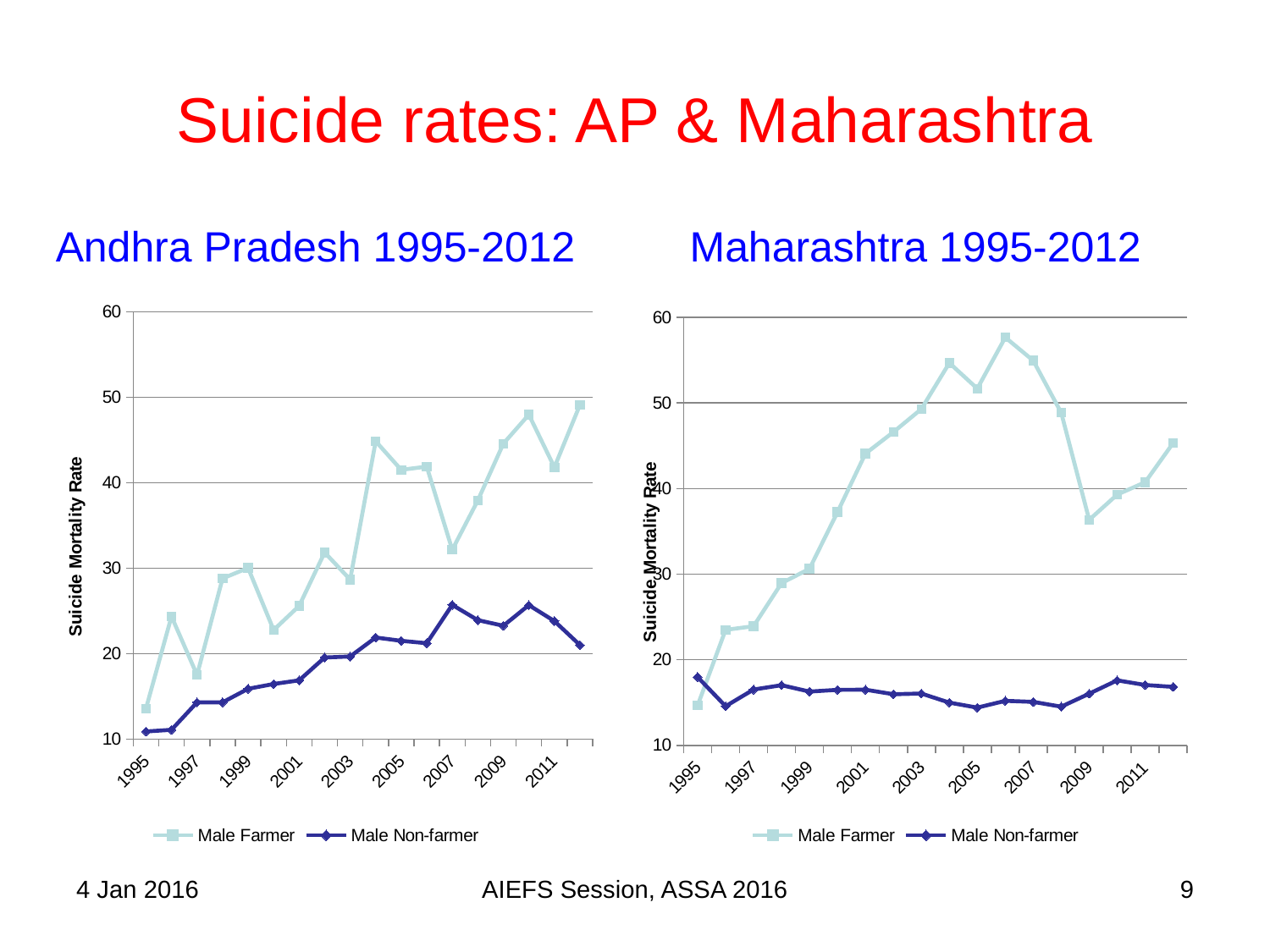
In the Andhra Pradesh 1995-2012 chart, which series has the higher value in 2012, Male Farmer or Male Non-farmer? Male Farmer How many series does the legend of the Maharashtra 1995-2012 chart list? 2 In the Maharashtra 1995-2012 chart, does the Male Farmer series rise or fall from 2006 to 2009? fall In the Andhra Pradesh 1995-2012 chart, is the Male Farmer value for 2012 greater or less than 40? greater What is the y-axis label of the Andhra Pradesh 1995-2012 chart? Suicide Mortality Rate In the Maharashtra 1995-2012 chart, is the Male Farmer value for 2009 greater or less than 40? less In the Maharashtra 1995-2012 chart, is the Male Farmer value for 2006 greater or less than 50? greater In the Andhra Pradesh 1995-2012 chart, does the Male Non-farmer series overall rise or fall from 1995 to 2012? rise In the Maharashtra 1995-2012 chart, which series has the higher value in 1995, Male Farmer or Male Non-farmer? Male Non-farmer How many data points does each series have in the Maharashtra 1995-2012 chart? 18 What kind of chart is the Andhra Pradesh 1995-2012 chart? line chart